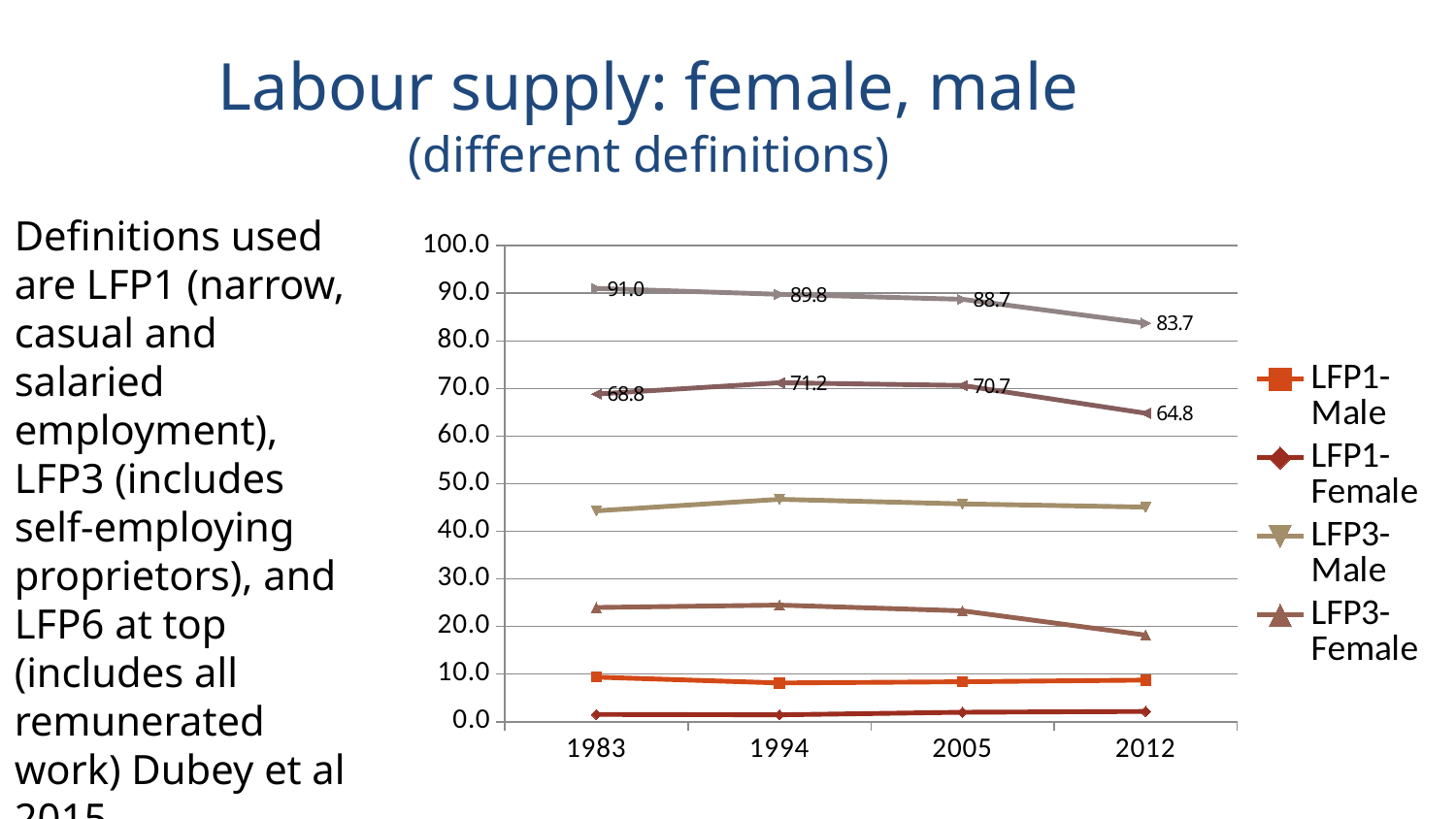
In which year does the second-highest line reach its highest labelled value? 1994 What is the value of the topmost line in 1983? 91.0 How many series does the chart's legend list? 4 By how much does the topmost line fall between 1983 and 2012? 7.3 What is the value of the second-highest line in 1994? 71.2 Does the topmost line rise or fall from 1983 to 2012? fall In 2012, which is larger, LFP1-Male or LFP1-Female? LFP1-Male How many years are plotted along the x axis? 4 What is the value of the topmost line in 2012? 83.7 What kind of chart is shown on the slide? line chart Is the value for LFP3-Male in 1994 greater or less than 40? greater Is the value for LFP3-Female in 1983 greater or less than 20? greater